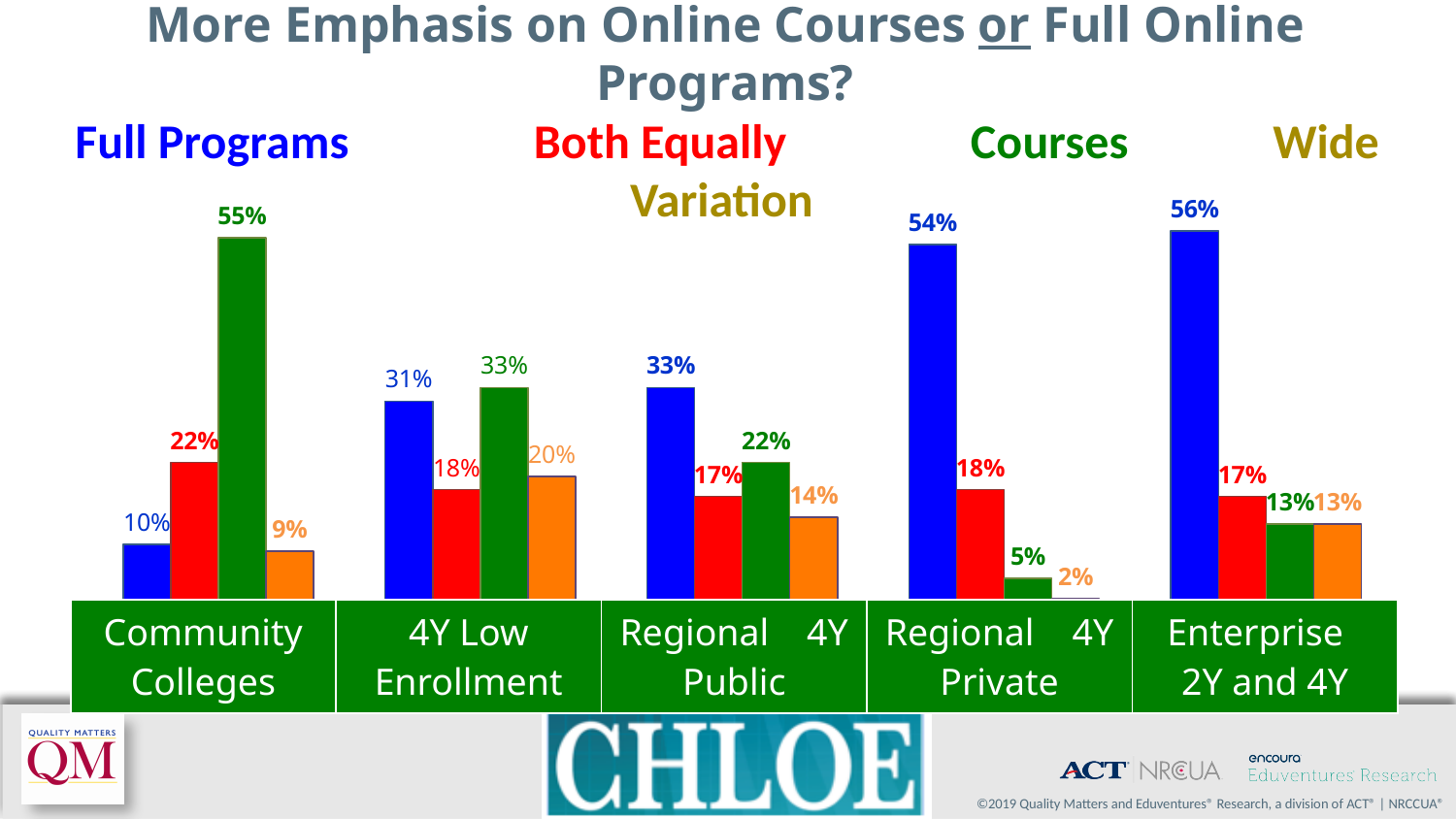
How many series does the chart show? 4 What is the difference between the Full Programs and Courses values for Community Colleges? 45% What is the Wide Variation value for 4Y Low Enrollment? 20% Which is larger for Regional 4Y Public: Full Programs or Courses? Full Programs What kind of chart is shown on the slide? bar chart What is the Courses value for Community Colleges? 55% Which institution type has the lowest Courses value? Regional 4Y Private What is the Full Programs value for Regional 4Y Private? 54% Which colour represents the Both Equally series? red Which institution type has the highest Full Programs value? Enterprise 2Y and 4Y How many institution types are shown on the x axis? 5 What is the Both Equally value for Regional 4Y Public? 17%